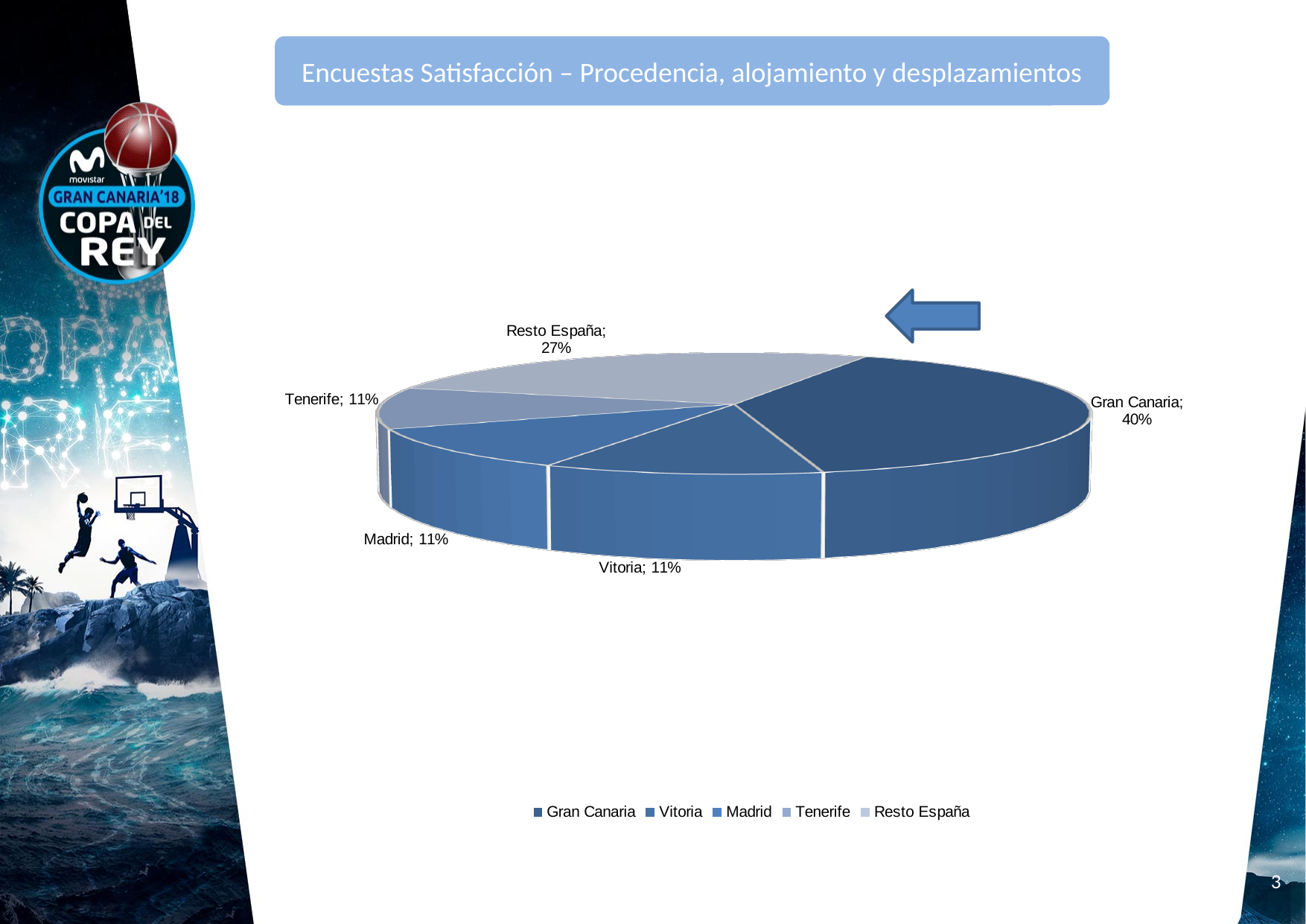
What share of the pie does Gran Canaria represent? 40% What is the difference between the Gran Canaria share and the Resto España share? 13% What kind of chart is shown on the slide? Pie chart Which category has the largest slice of the pie? Gran Canaria What is the title shown in the header box of the slide? Encuestas Satisfacción – Procedencia, alojamiento y desplazamientos What is the value shown for Vitoria? 11% What is the combined share of Madrid, Tenerife and Vitoria? 33% How many entries does the legend list? 5 How many categories are shown in the pie chart? 5 What is the value shown for Resto España? 27% What is the value shown for Tenerife? 11% Which is larger, the share for Resto España or the share for Madrid? Resto España